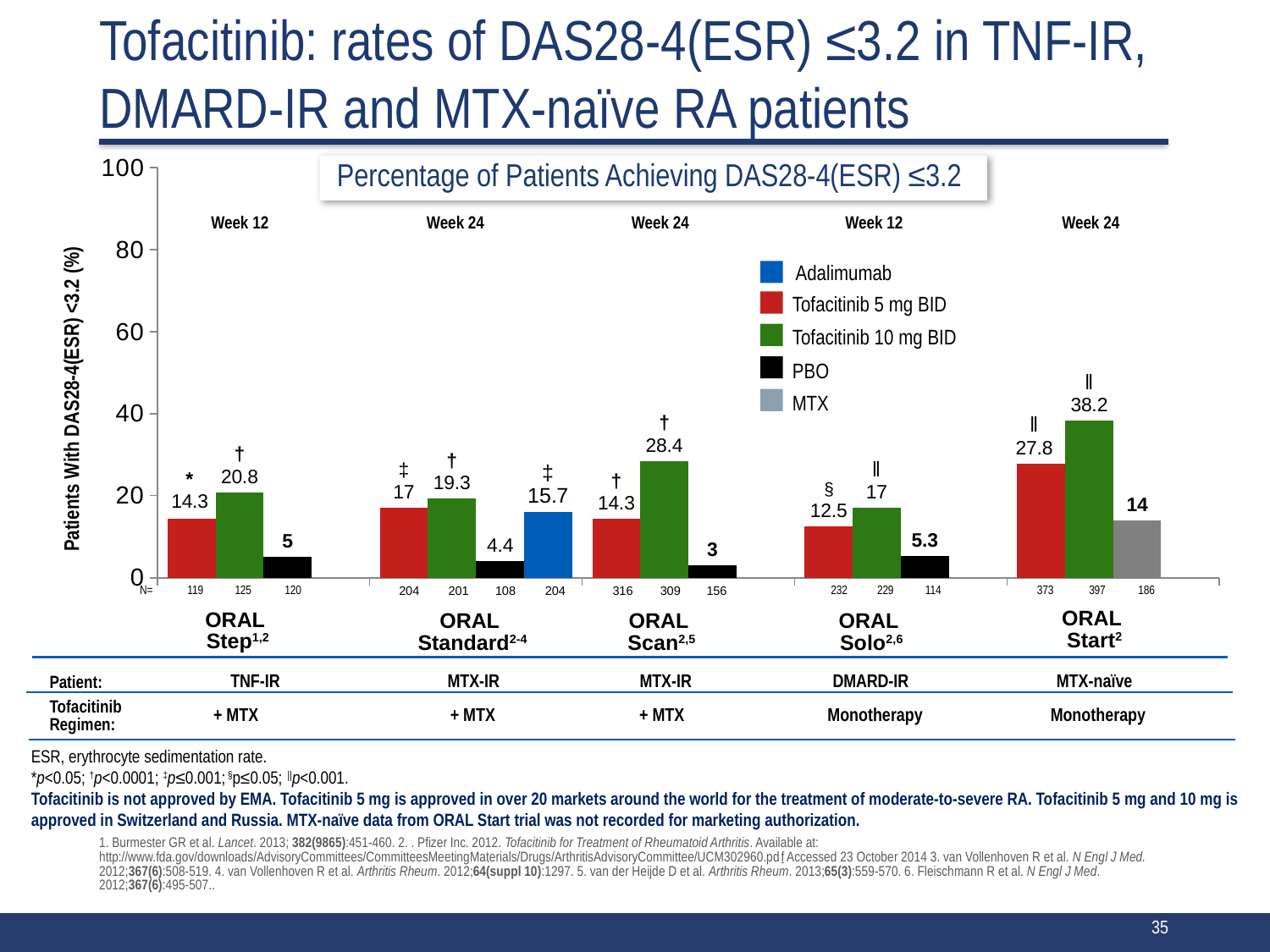
In the ORAL Standard trial, which is larger: Tofacitinib 5 mg BID or Adalimumab? Tofacitinib 5 mg BID What colour represents PBO in the legend? Black What is the value for MTX in the ORAL Start trial? 14 What is the value for Tofacitinib 10 mg BID in the ORAL Start trial? 38.2 Which bar has the lowest value on the chart? PBO in ORAL Scan (3) How many series does the legend list? 5 Which bar has the highest value on the chart? Tofacitinib 10 mg BID in ORAL Start (38.2) What kind of chart is shown on the slide? Bar chart How many trials (groups of bars) are shown on the chart? 5 What is the value for Adalimumab in the ORAL Standard trial? 15.7 What is the value for PBO in the ORAL Standard trial? 4.4 In the ORAL Scan trial, what is the difference between the Tofacitinib 10 mg BID and Tofacitinib 5 mg BID values? 14.1